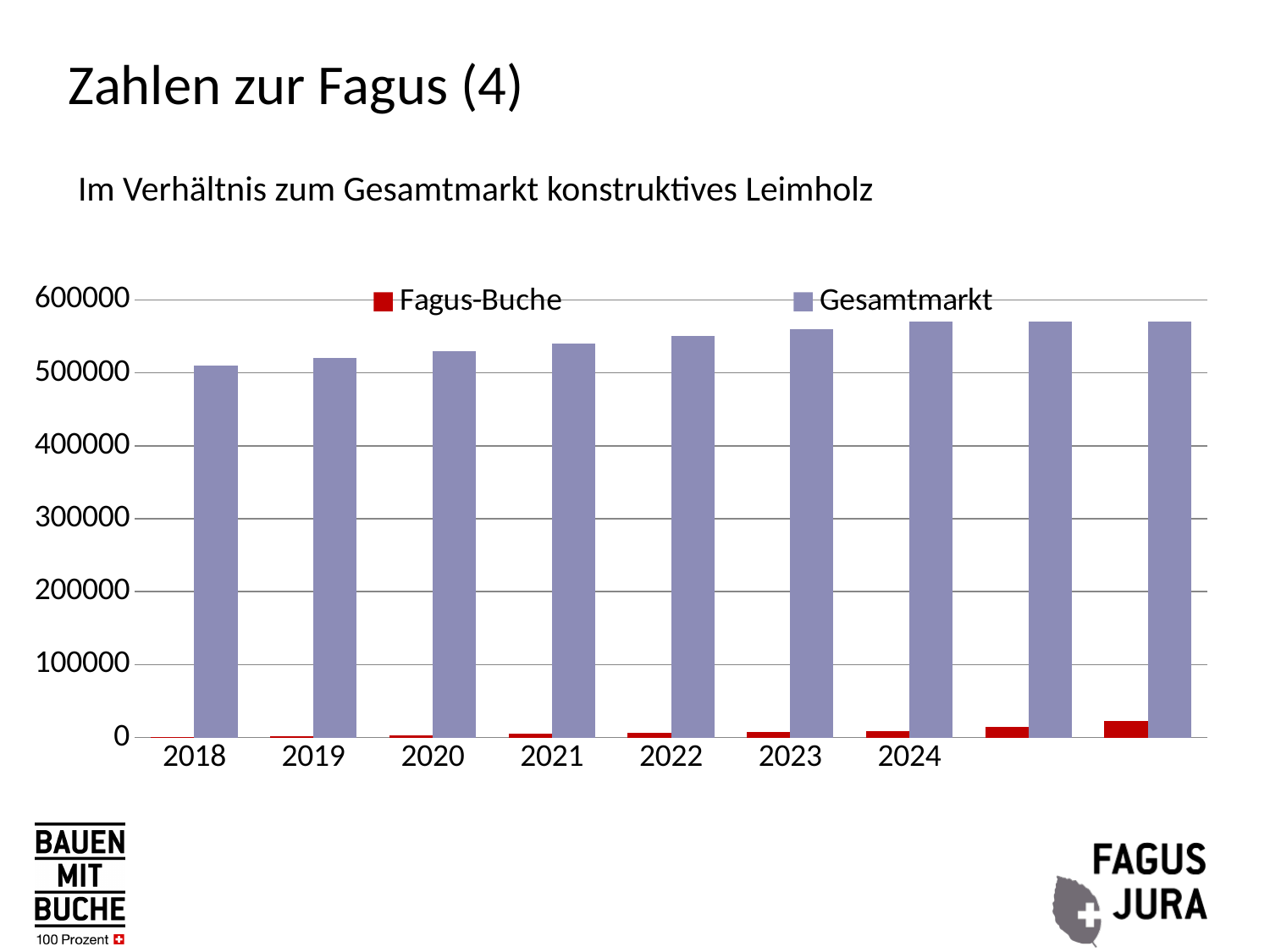
How many year labels are shown on the x axis? 7 Which colour represents the Gesamtmarkt series? purple Is the Fagus-Buche value for 2024 greater or less than 100000? less Is the Gesamtmarkt value for 2021 greater or less than 500000? greater In 2020, which series has the larger value, Fagus-Buche or Gesamtmarkt? Gesamtmarkt Is the Gesamtmarkt value for 2018 greater or less than 600000? less Among the labeled years, which year has the lowest Fagus-Buche value? 2018 What kind of chart is shown on the slide? bar chart Do the Gesamtmarkt values rise or fall from 2018 to 2024? rise What are the two series named in the legend? Fagus-Buche and Gesamtmarkt How many series does the legend list? 2